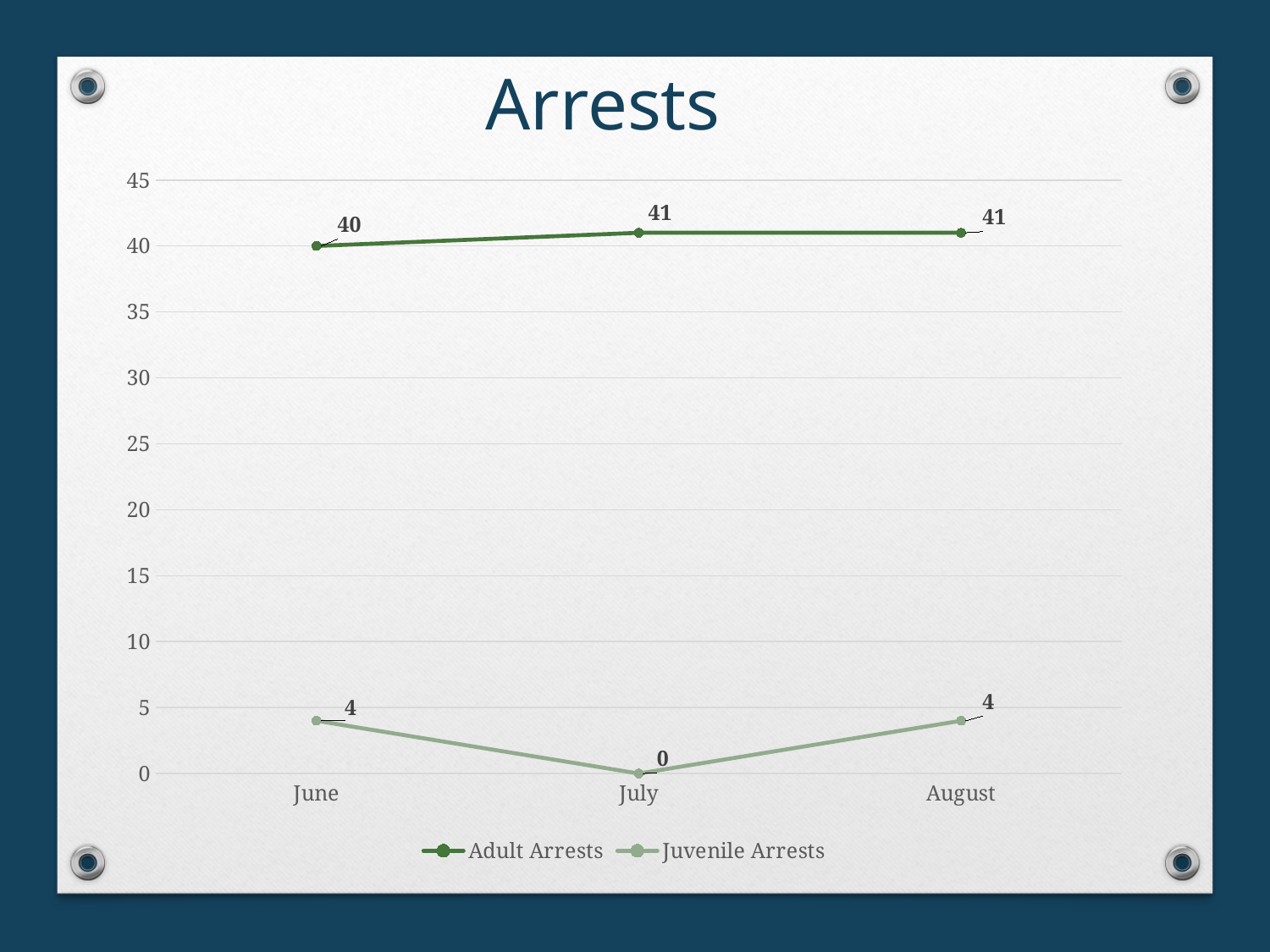
How many months are shown on the x axis? 3 In which month is Juvenile Arrests lowest? July How many series does the legend list? 2 What is the value for Juvenile Arrests in July? 0 Which is larger in August, Adult Arrests or Juvenile Arrests? Adult Arrests What is the title of the chart? Arrests What kind of chart is shown on the slide? Line chart What is the difference between Adult Arrests in July and in June? 1 What is the value for Adult Arrests in August? 41 What is the difference between Adult Arrests and Juvenile Arrests in June? 36 What is the value for Adult Arrests in June? 40 Is the value for Adult Arrests in July greater or less than 35? greater